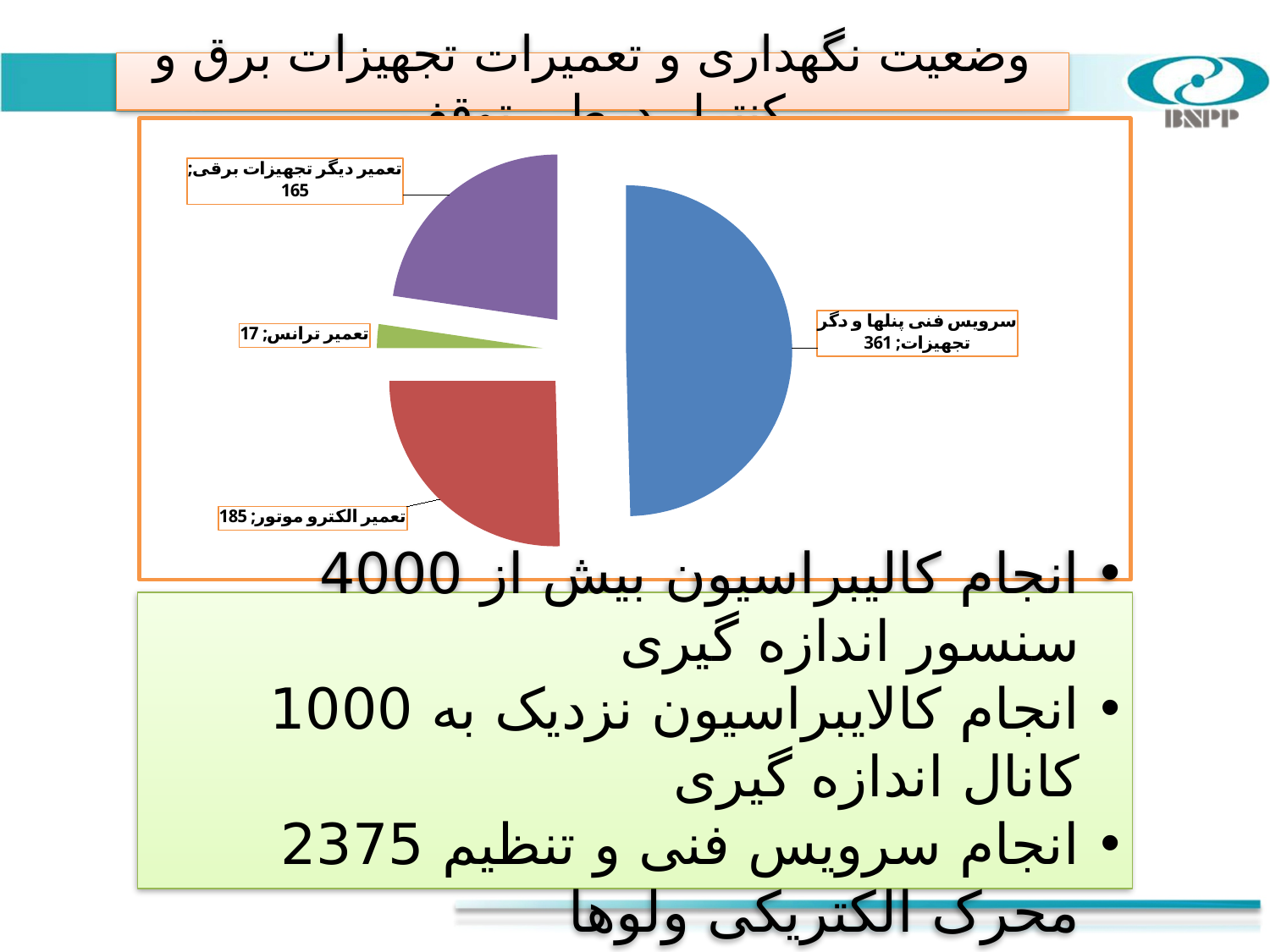
What kind of chart is shown on the slide? pie chart What is the total of all four slices in the pie chart? 728 Which category has the largest slice of the pie? سرویس فنی پنلها و دگر تجهیزات What is the value for تعمیر ترانس? 17 What is the value for تعمیر دیگر تجهیزات برقی? 165 What is the value for تعمیر الکترو موتور? 185 What is the difference between the values for تعمیر الکترو موتور and تعمیر دیگر تجهیزات برقی? 20 Which category has the smallest slice of the pie? تعمیر ترانس How many slices does the pie chart have? 4 What colour is the slice for تعمیر ترانس? green Which is larger, the value for تعمیر الکترو موتور or the value for تعمیر دیگر تجهیزات برقی? تعمیر الکترو موتور What is the value for سرویس فنی پنلها و دگر تجهیزات? 361